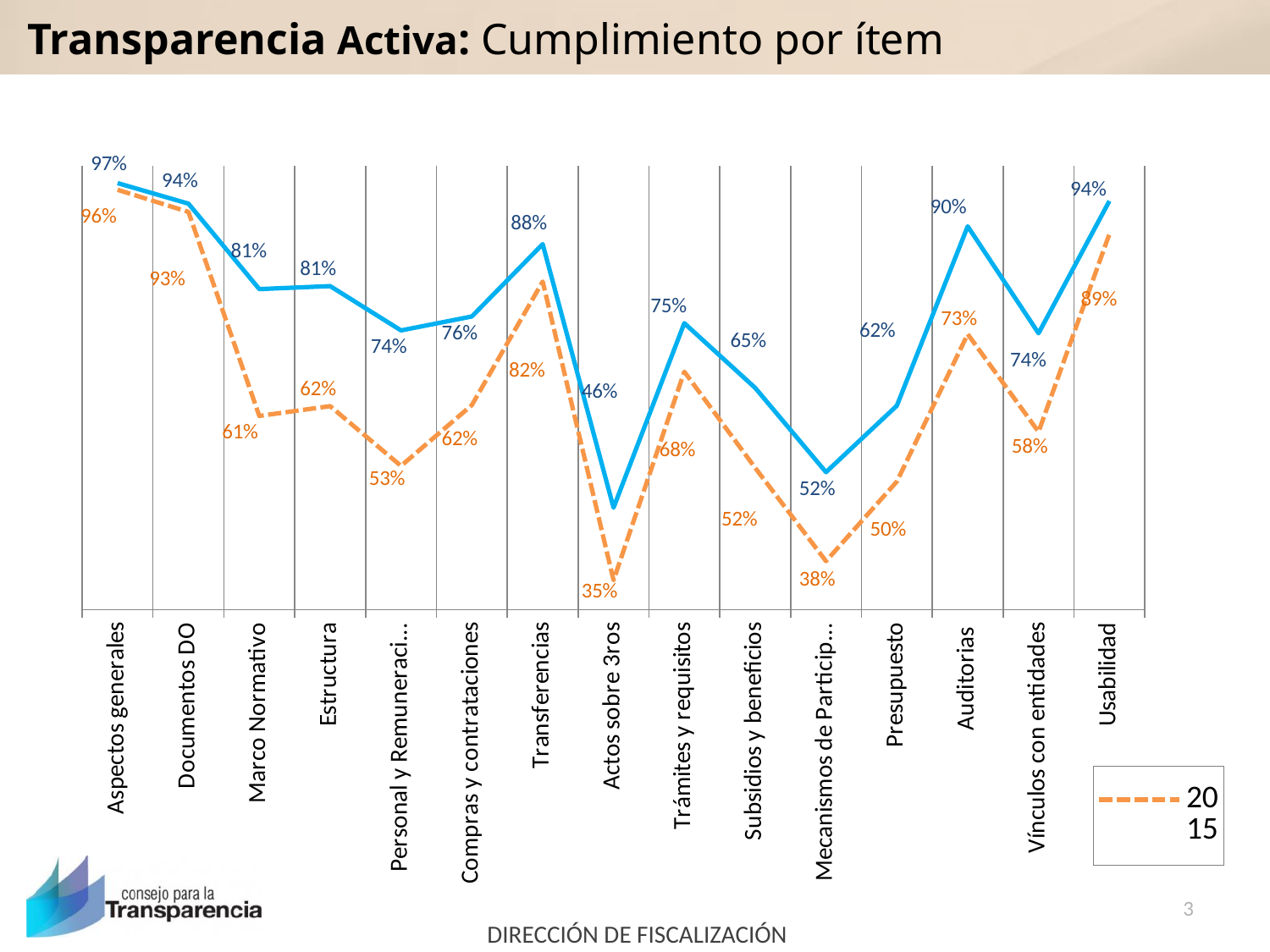
What is the value of the solid blue line for Transferencias? 88% What is the value of the dashed orange line for Mecanismos de Particip...? 38% What is the value of the dashed orange line for Actos sobre 3ros? 35% What is the difference between the solid blue line and the dashed orange line for Marco Normativo? 20% Does the solid blue line rise or fall from Actos sobre 3ros to Trámites y requisitos? rise Which category has the highest value on the solid blue line? Aspectos generales What type of chart is shown on the slide? line chart Which category has the lowest value on the dashed orange line? Actos sobre 3ros What is the title of the slide containing the chart? Transparencia Activa: Cumplimiento por ítem What is the value of the solid blue line for Auditorias? 90% How many categories are shown on the x axis? 15 Which is larger for Presupuesto: the solid blue line value or the dashed orange line value? the solid blue line (62%)